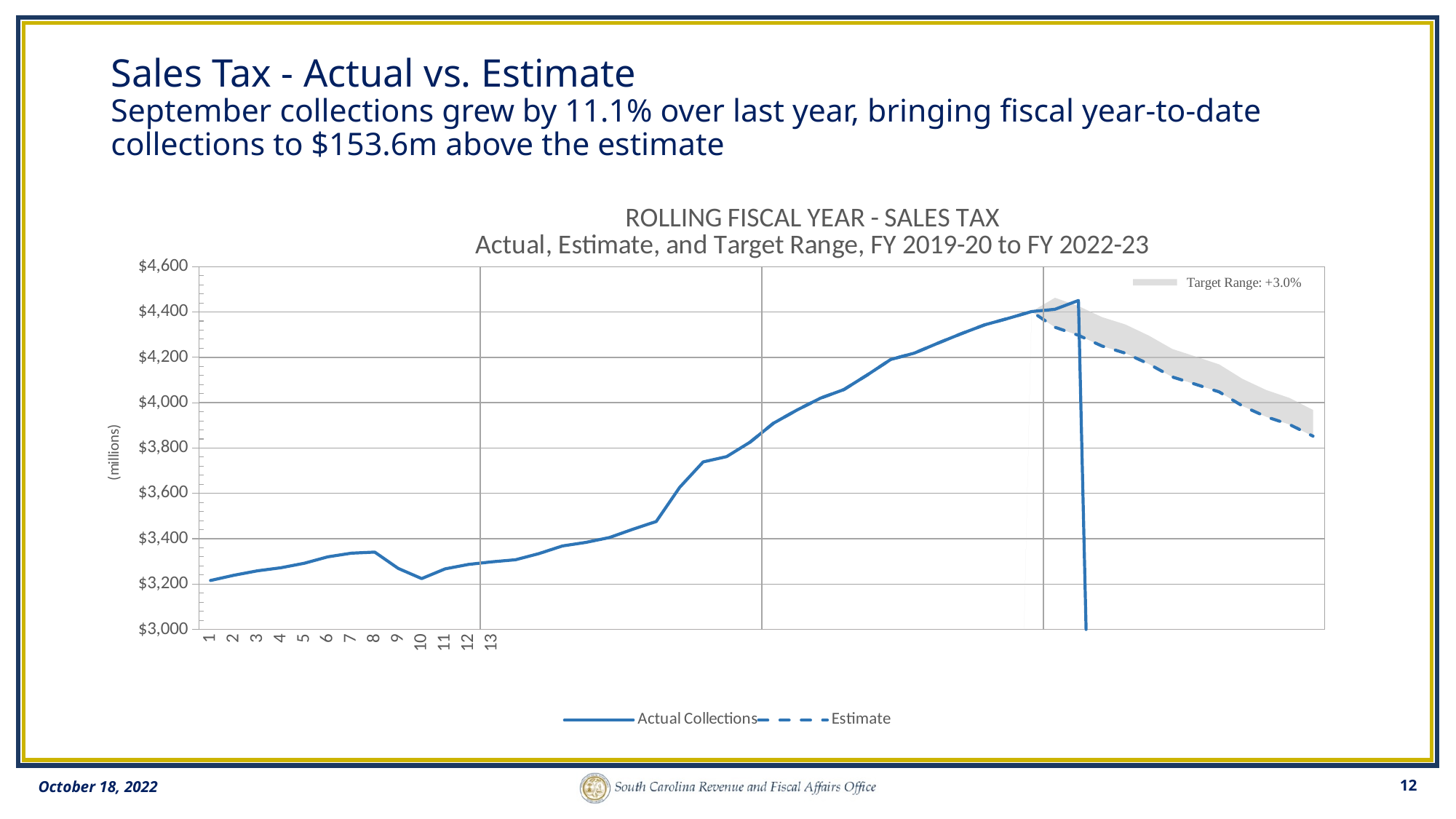
What is the lowest value shown on the y axis? $3,000 What kind of chart is shown on the slide? Line chart Is the final value of the Estimate line (at the right edge of the chart) greater or less than $4,000? less How many series does the chart legend list? 2 Does the Actual Collections line generally rise or fall from point 1 up to its peak? Rise Is the highest value of the Actual Collections line greater or less than $4,400? greater Is the value of the Actual Collections line at point 8 greater or less than $3,400? less Which is higher at the right edge of the chart, the Estimate line or the top of the Target Range band? Target Range band What are the two series named in the chart legend? Actual Collections and Estimate What is the title of the chart? ROLLING FISCAL YEAR - SALES TAX Actual, Estimate, and Target Range, FY 2019-20 to FY 2022-23 Does the Estimate line rise or fall as it moves to the right along the x axis? Fall